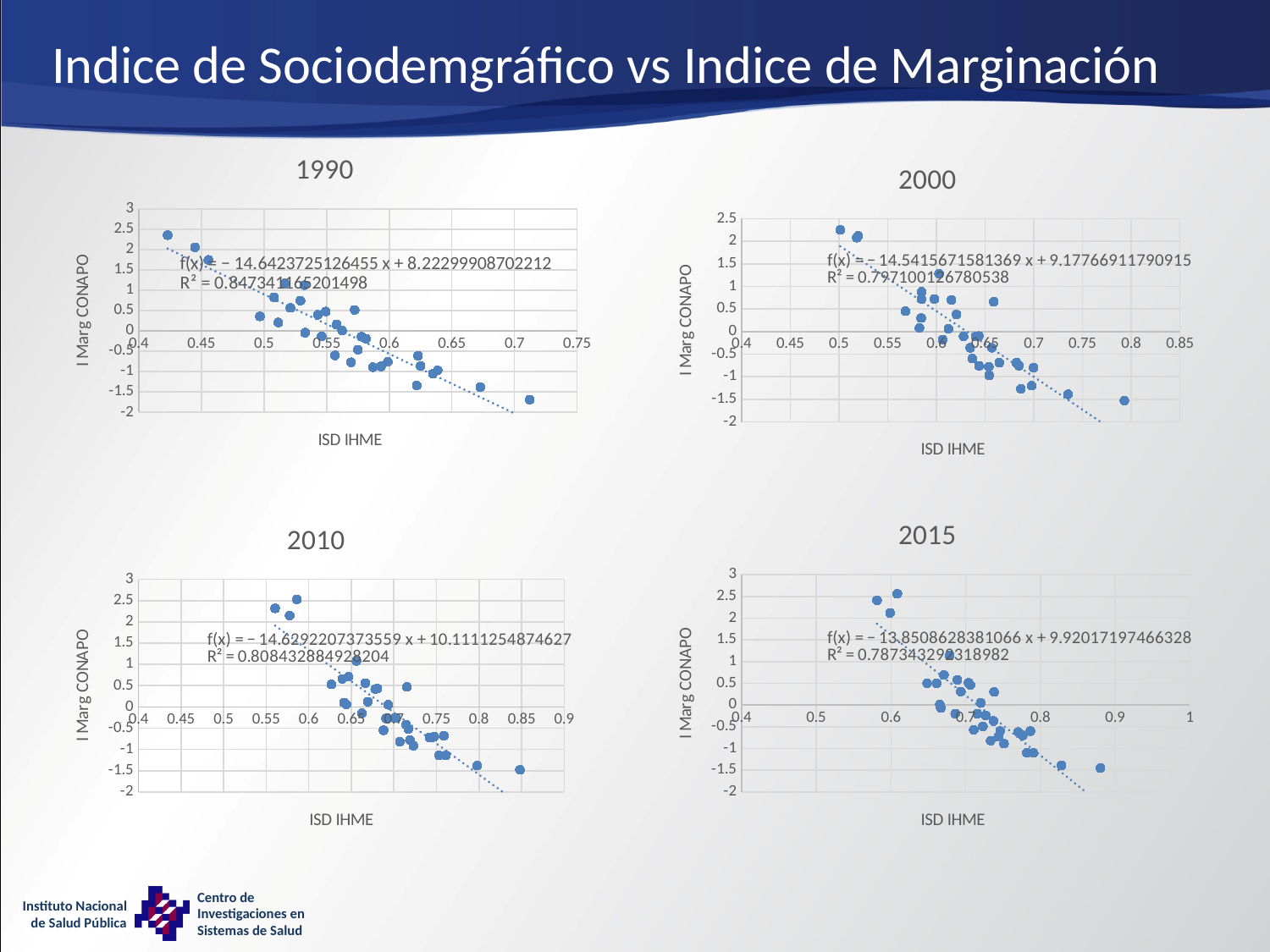
In the 2015 chart, do the plotted values rise or fall along the x axis? Fall What is the R² value shown on the 2010 chart? 0.808432884928204 Which of the four charts shows the highest R² value? 1990 What kind of chart is the 1990 chart? Scatter chart What is the intercept of the trendline equation shown on the 2010 chart? 10.1111254874627 In the 2015 chart, is the I Marg CONAPO value of the rightmost point (near ISD IHME 0.88) greater or less than -1? less How many charts are shown on the slide? 4 In the 2010 chart, do the I Marg CONAPO values rise or fall as ISD IHME increases? Fall What is the x-axis title of the 2000 chart? ISD IHME In the 1990 chart, is the I Marg CONAPO value of the leftmost point (near ISD IHME 0.42) greater or less than 2? greater What is the slope of the trendline equation shown on the 2015 chart? −13.8508628381066 What is the slope of the trendline equation shown on the 1990 chart? −14.6423725126455